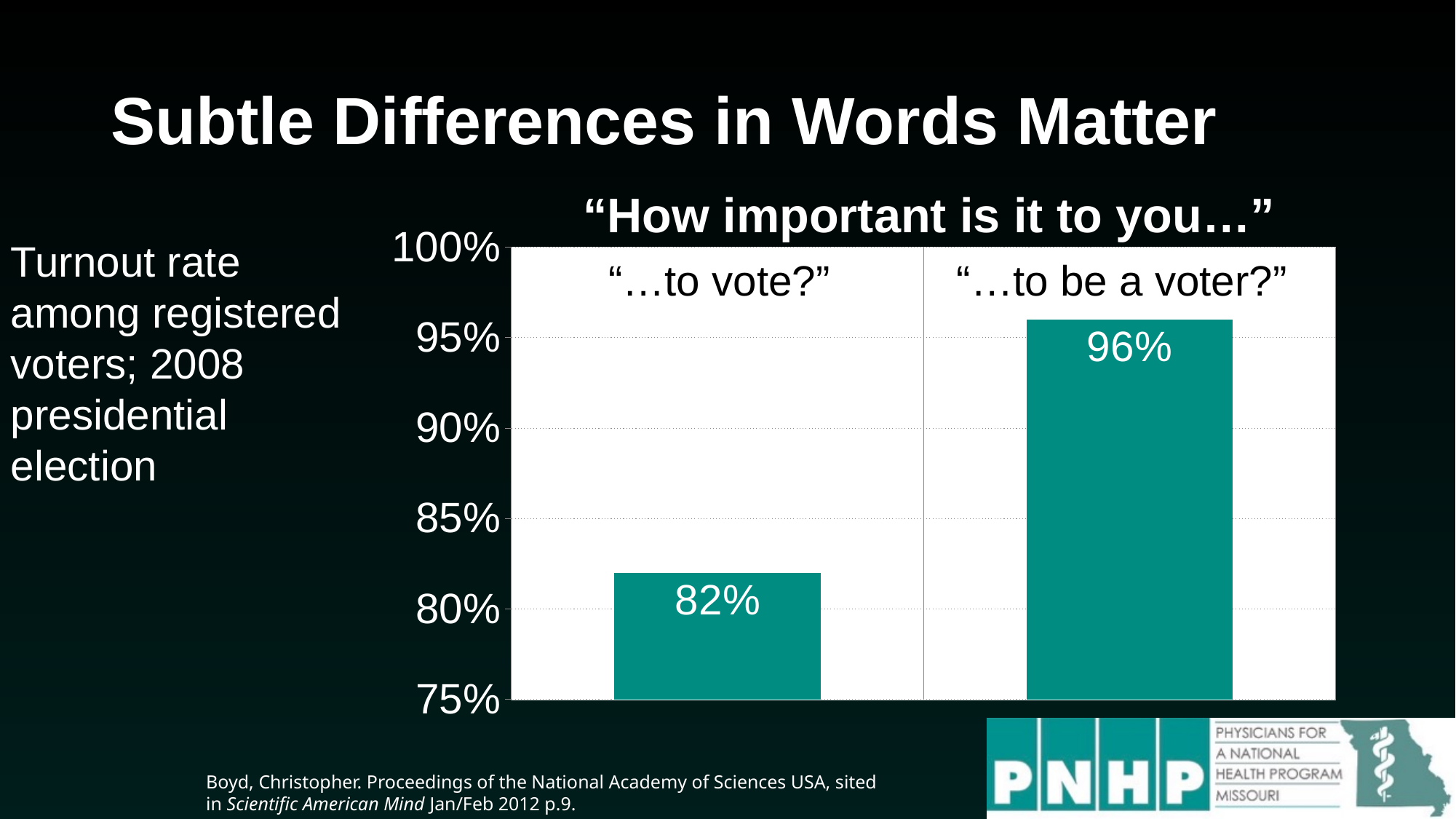
Is the value for "…to vote?" greater or less than 85%? less What is the lowest value shown on the chart's vertical axis? 75% Is the turnout rate for "…to vote?" larger or smaller than for "…to be a voter?"? smaller What is the turnout rate for the "…to vote?" wording? 82% What is the difference in turnout rate between "…to be a voter?" and "…to vote?"? 14% Which wording has the higher turnout rate? "…to be a voter?" What kind of chart is shown on the slide? bar chart Which wording has the lower turnout rate? "…to vote?" What is the turnout rate for the "…to be a voter?" wording? 96% How many bars are shown in the chart? 2 What is the title of the chart? "How important is it to you…" Is the value for "…to be a voter?" greater or less than 95%? greater